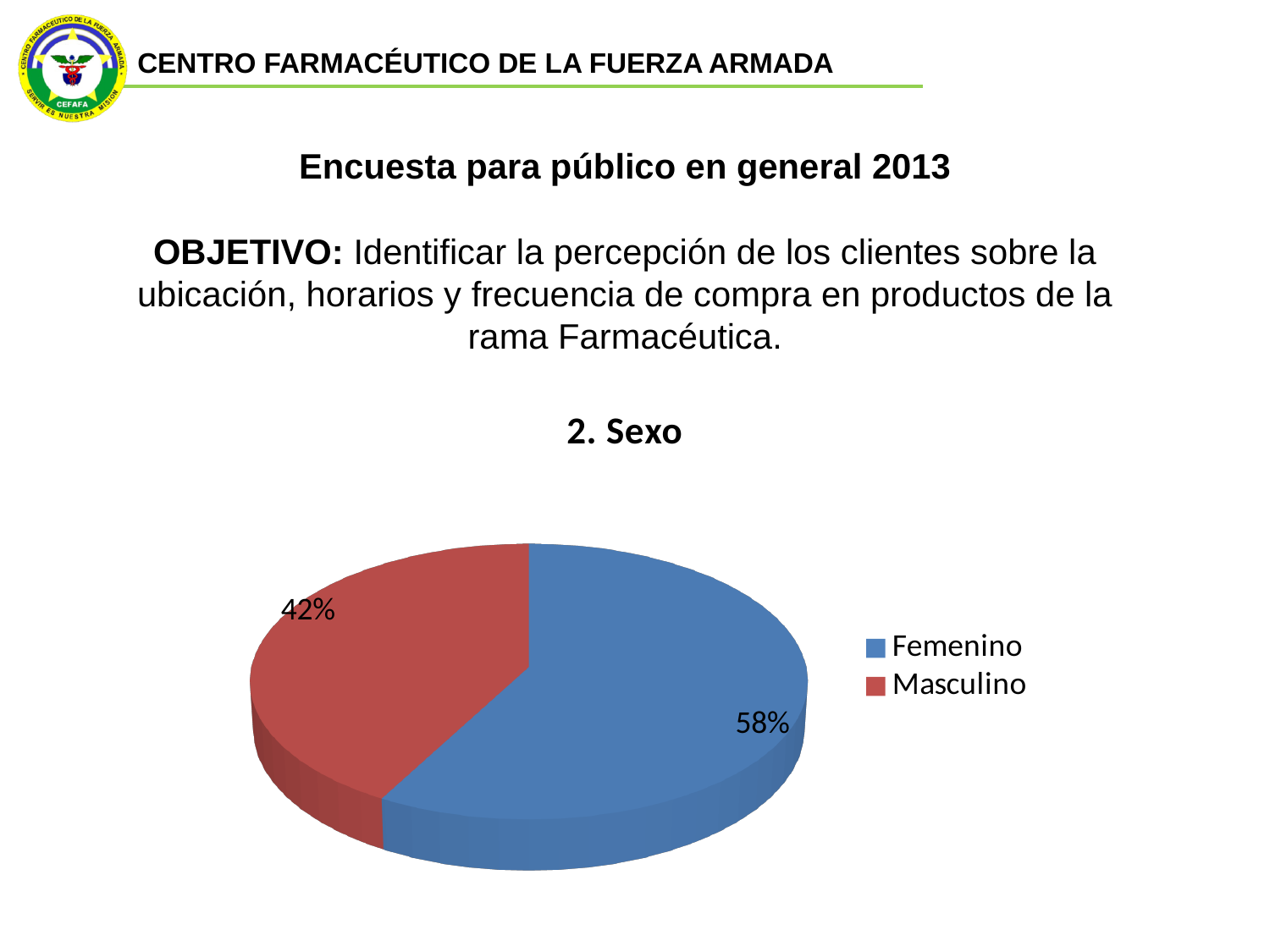
What share of the pie does Masculino represent? 42% What kind of chart is shown on the slide? pie chart Which category has the smallest slice of the pie? Masculino Which is larger, the Femenino slice or the Masculino slice? Femenino What share of the pie does Femenino represent? 58% How many entries does the legend list? 2 What is the title of the chart? 2. Sexo How many categories does the pie chart have? 2 What colour is the Masculino slice? red Which category has the largest slice of the pie? Femenino What is the difference in percentage points between Femenino and Masculino? 16 Is the value for Femenino greater or less than 50%? greater